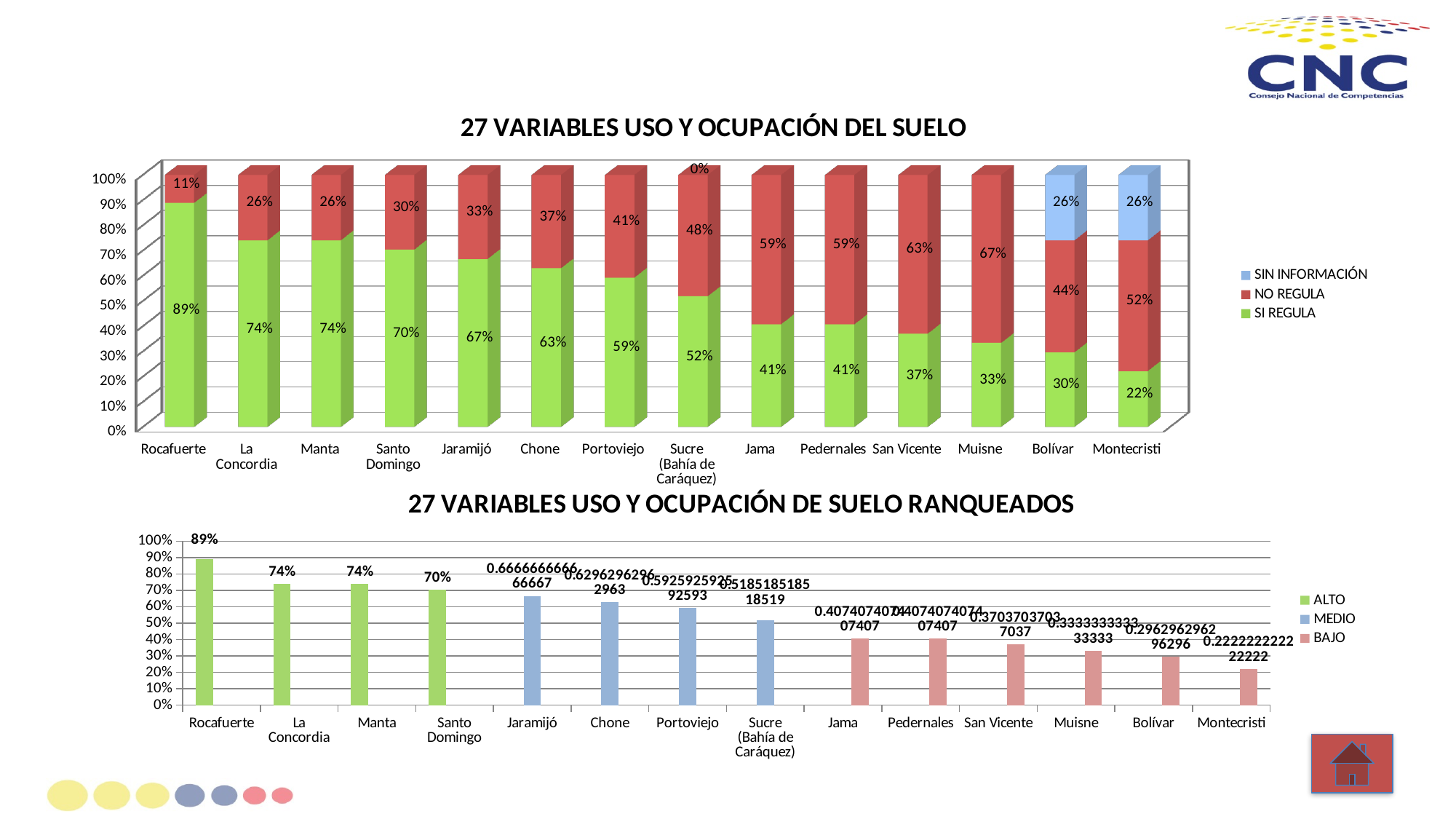
In the bottom chart '27 VARIABLES USO Y OCUPACIÓN DE SUELO RANQUEADOS', how many categories are shown on the x axis? 14 In the top chart '27 VARIABLES USO Y OCUPACIÓN DEL SUELO', which category has the lowest SI REGULA value? Montecristi In the bottom chart '27 VARIABLES USO Y OCUPACIÓN DE SUELO RANQUEADOS', what is the value for Manta? 74% In the top chart '27 VARIABLES USO Y OCUPACIÓN DEL SUELO', what is the SI REGULA value for Rocafuerte? 89% In the top chart '27 VARIABLES USO Y OCUPACIÓN DEL SUELO', how many series does the legend list? 3 In the top chart '27 VARIABLES USO Y OCUPACIÓN DEL SUELO', what is the SIN INFORMACIÓN value for Bolívar? 26% In the top chart '27 VARIABLES USO Y OCUPACIÓN DEL SUELO', what is the NO REGULA value for Muisne? 67% In the top chart '27 VARIABLES USO Y OCUPACIÓN DEL SUELO', what is the difference between the SI REGULA values for Rocafuerte and Chone? 26% In the bottom chart '27 VARIABLES USO Y OCUPACIÓN DE SUELO RANQUEADOS', which category has the highest value? Rocafuerte What kind of chart is the bottom chart '27 VARIABLES USO Y OCUPACIÓN DE SUELO RANQUEADOS'? bar chart In the top chart '27 VARIABLES USO Y OCUPACIÓN DEL SUELO', which is larger: the NO REGULA value for Jama or the NO REGULA value for Santo Domingo? Jama In the bottom chart '27 VARIABLES USO Y OCUPACIÓN DE SUELO RANQUEADOS', do the values rise or fall from left to right along the x axis? fall